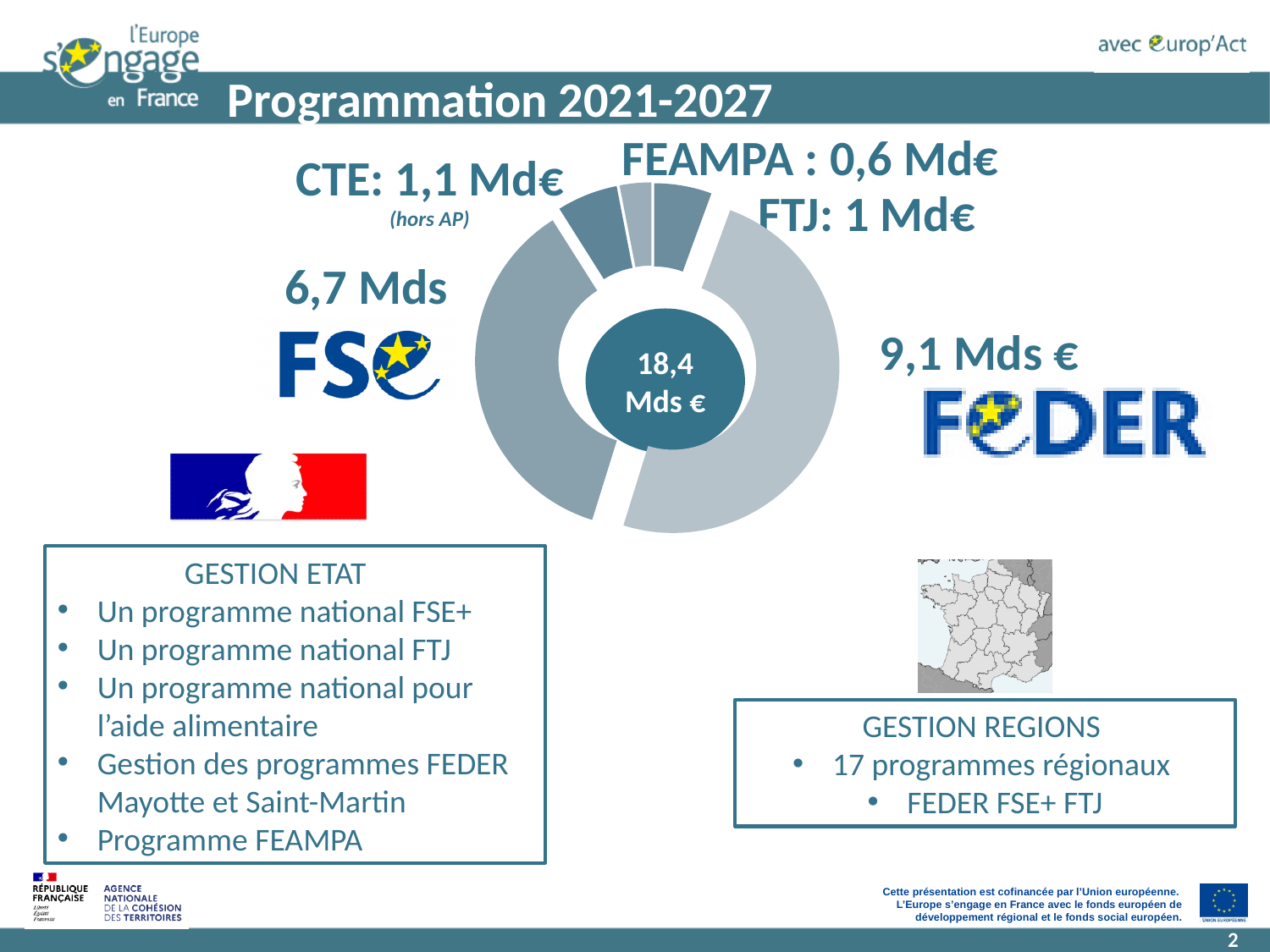
Which fund has the smallest amount in the chart? FEAMPA What type of chart is shown on the slide? Donut (pie) chart How many funds (segments) are labelled around the donut chart? 5 What amount is shown for FEDER? 9,1 Mds € Which fund has the largest amount in the chart? FEDER Which is larger, the amount for CTE or the amount for FTJ? CTE What amount is shown for FTJ? 1 Md€ What amount is shown for FSE? 6,7 Mds What is the total amount shown in the centre of the donut chart? 18,4 Mds € What is the difference between the FEDER amount and the FSE amount? 2,4 Mds € What amount is shown for FEAMPA? 0,6 Md€ What amount is shown for CTE? 1,1 Md€